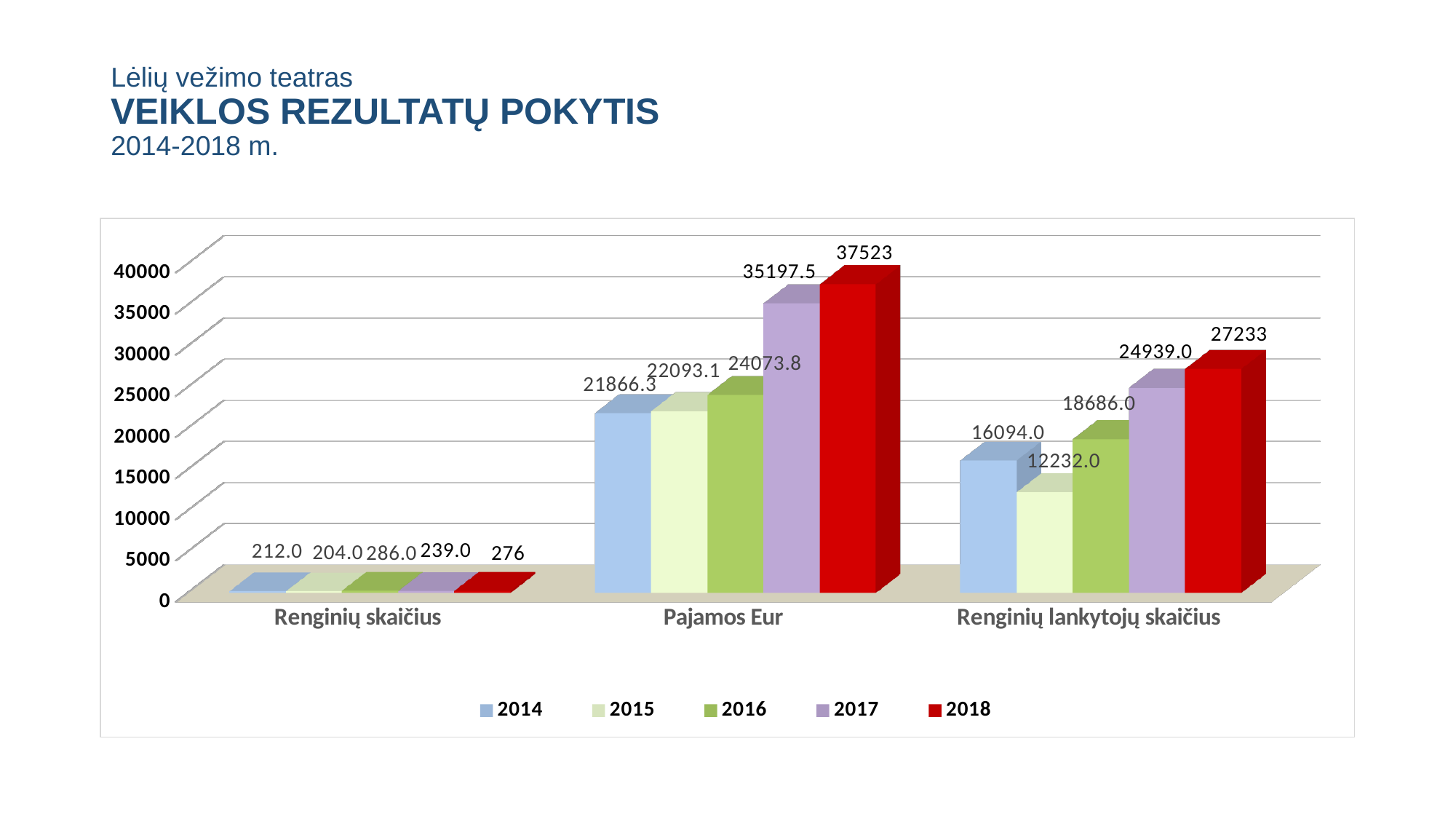
What is the value for 2015 in the Renginių lankytojų skaičius category? 12232.0 What kind of chart is shown on the slide? bar chart What is the value for 2018 in the Pajamos Eur category? 37523 Which year has the lowest value in the Renginių lankytojų skaičius category? 2015 What is the value for 2016 in the Renginių skaičius category? 286.0 What is the difference between the 2017 and 2016 values in the Renginių lankytojų skaičius category? 6253.0 Which is larger: the 2014 value or the 2015 value in the Renginių lankytojų skaičius category? 2014 What is the difference between the 2018 and 2017 values in the Pajamos Eur category? 2325.5 How many categories are shown on the x axis? 3 Which year has the lowest value in the Renginių skaičius category? 2015 How many series does the legend list? 5 Which year has the highest value in the Pajamos Eur category? 2018